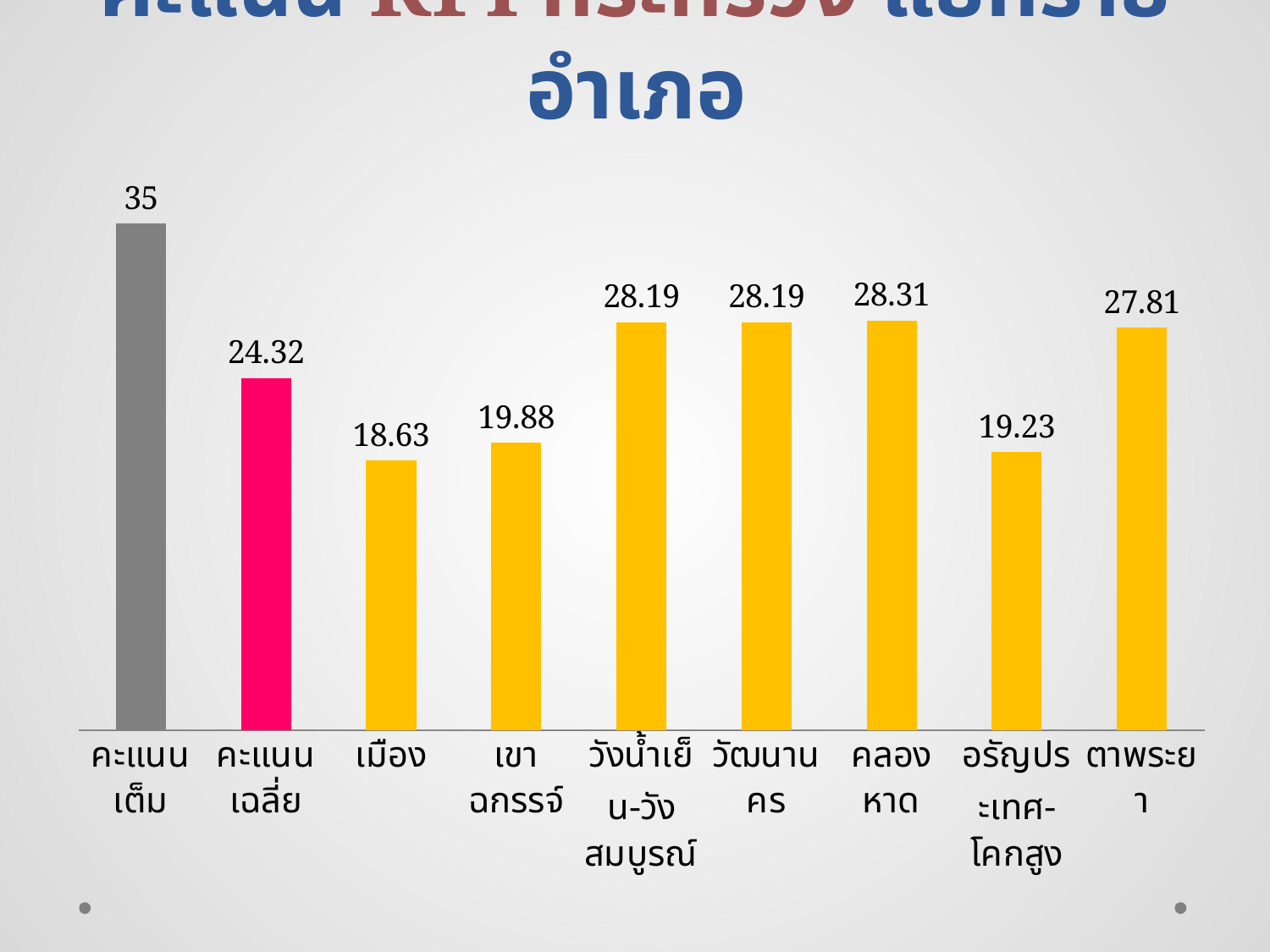
Which category has the highest value in the chart? คะแนนเต็ม What colour is the bar for คะแนนเฉลี่ย? pink Which has a larger value, เขาฉกรรจ์ or อรัญประเทศ-โคกสูง? เขาฉกรรจ์ What is the value shown for คะแนนเฉลี่ย? 24.32 What is the value shown for ตาพระยา? 27.81 What is the value shown for คลองหาด? 28.31 What is the value shown for คะแนนเต็ม? 35 How many bars are plotted in the chart? 9 What type of chart is shown on the slide? bar chart What is the difference between the values for คะแนนเต็ม and คะแนนเฉลี่ย? 10.68 Which category has the lowest value in the chart? เมือง What is the value shown for เมือง? 18.63